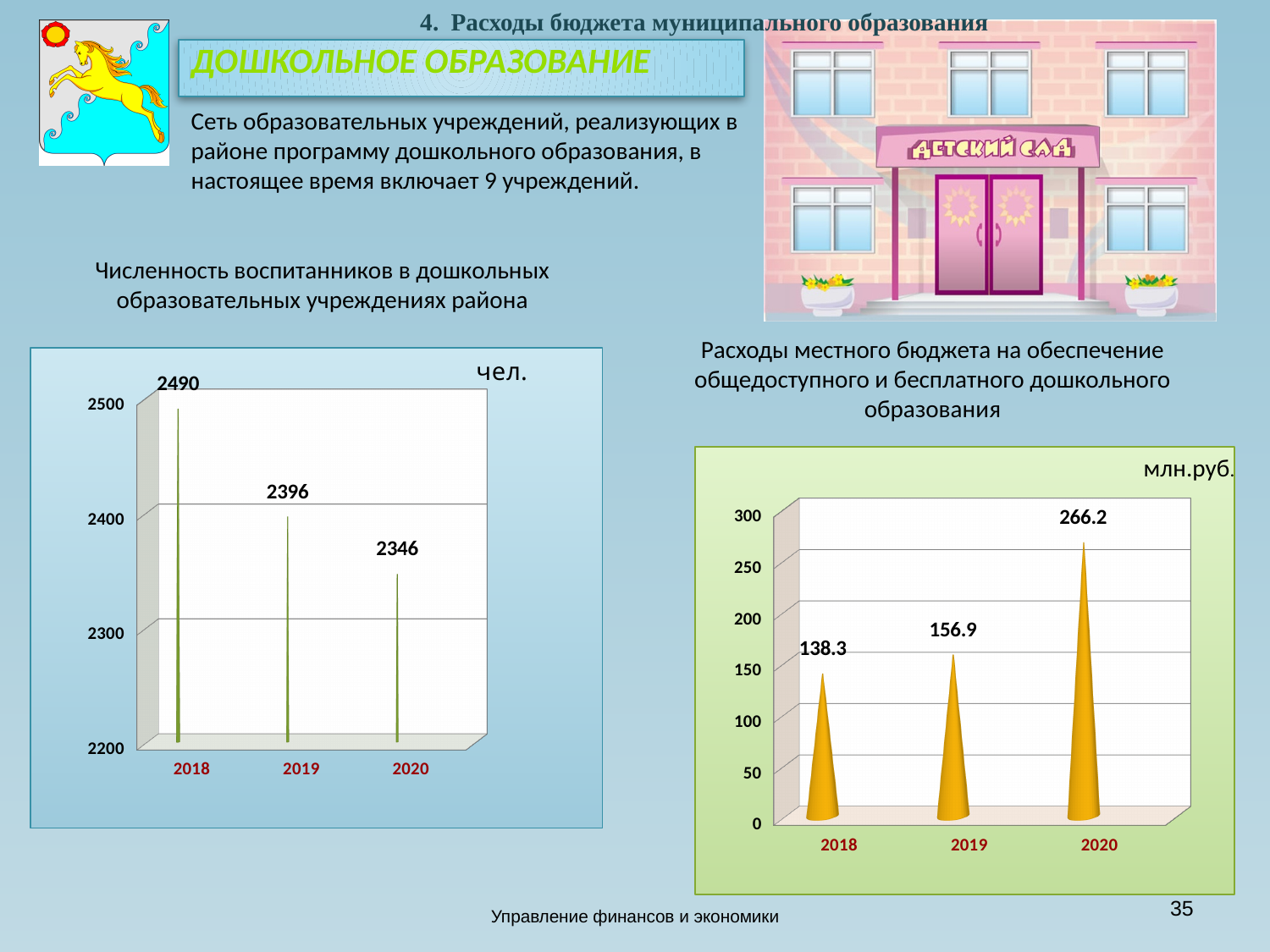
On the right chart (Расходы местного бюджета), what is the difference between the 2020 and 2018 values? 127.9 On the right chart (Расходы местного бюджета), which is larger, the value for 2018 or the value for 2019? 2019 On the left chart (Численность воспитанников), how many years are shown on the x axis? 3 On the left chart (Численность воспитанников), which year has the lowest value? 2020 On the left chart (Численность воспитанников), do the values rise or fall from 2018 to 2020? fall On the left chart (Численность воспитанников в дошкольных образовательных учреждениях района), what is the value for 2018? 2490 On the left chart (Численность воспитанников), what is the difference between the 2018 and 2019 values? 94 On the right chart (Расходы местного бюджета на обеспечение общедоступного и бесплатного дошкольного образования), what is the value for 2019? 156.9 What kind of chart is the right chart (Расходы местного бюджета)? bar chart On the right chart (Расходы местного бюджета), what unit is shown in the top right corner of the chart? млн.руб. On the right chart (Расходы местного бюджета), which year has the highest value? 2020 On the left chart (Численность воспитанников), what is the value for 2020? 2346